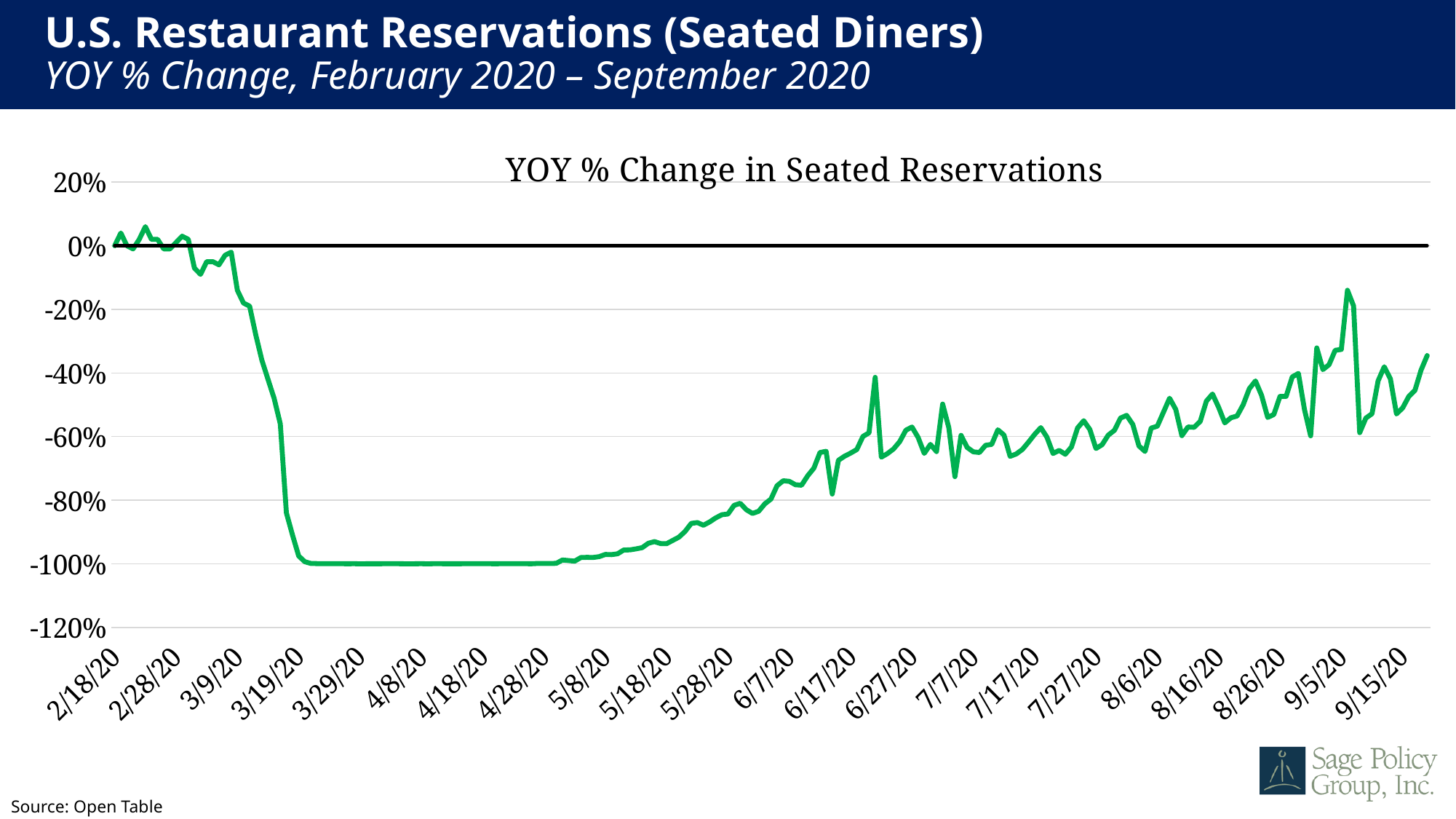
Is the value on 4/8/20 greater or less than -80%? less How many data series (lines) are plotted on the chart? 2 What type of chart is shown on the slide? line chart Which date has the larger value, 2/18/20 or 4/8/20? 2/18/20 Between 3/9/20 and 3/19/20, do the values rise or fall? fall Between 4/28/20 and 6/7/20, do the values rise or fall? rise Is the value on 6/7/20 greater or less than -60%? less Is the value on 3/9/20 greater or less than -20%? greater What is the title printed above the chart's plot area? YOY % Change in Seated Reservations What source is cited for the chart data? Open Table What value does the line plateau at from late March through April 2020? -100%